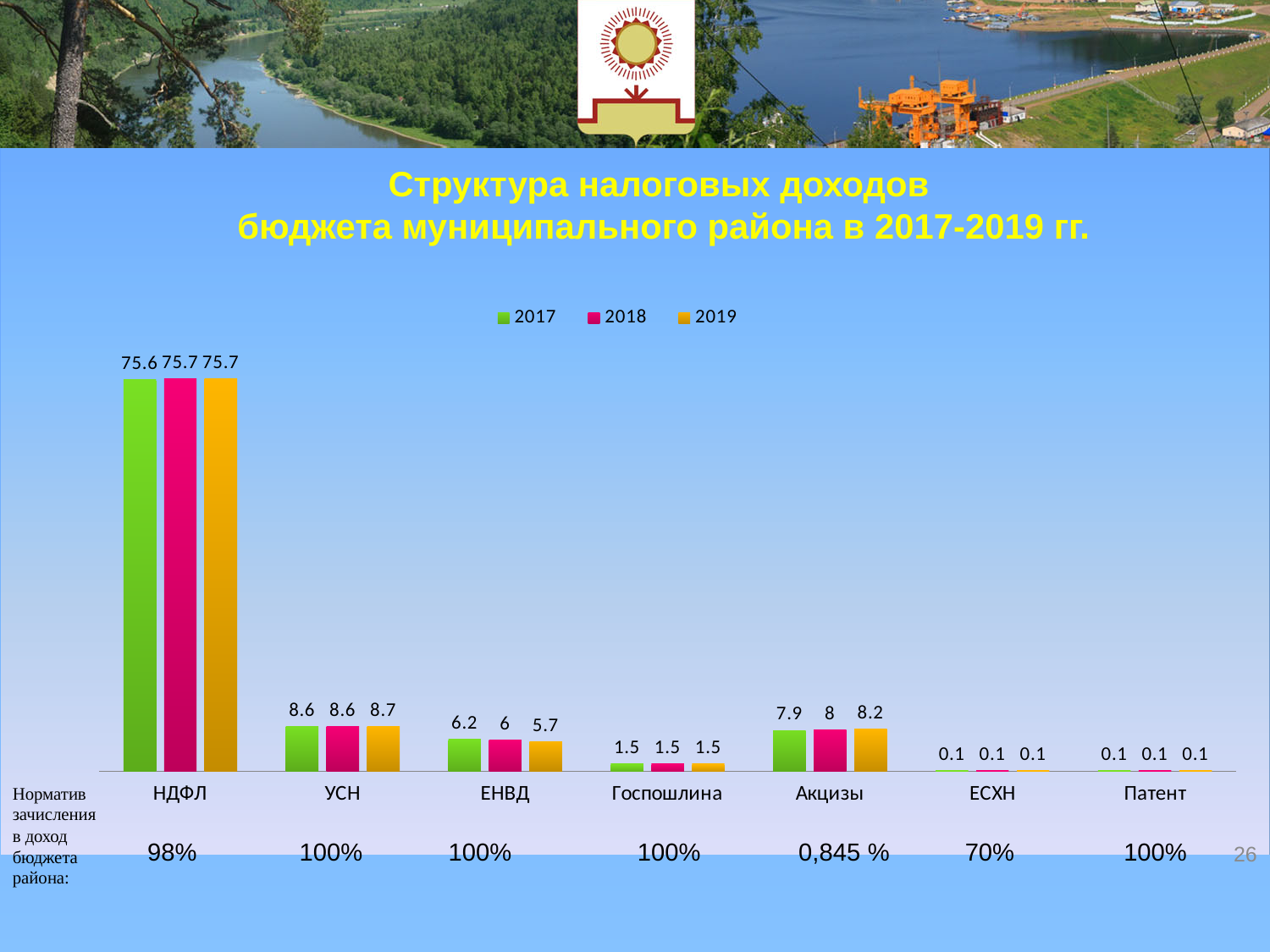
How many series does the legend list? 3 How many categories are shown on the x axis? 7 What is the value for ЕНВД in 2019? 5.7 What is the value for Акцизы in 2018? 8 What is the difference between the 2017 and 2019 values for ЕНВД? 0.5 What is the difference between the 2019 values for НДФЛ and УСН? 67 What is the value for НДФЛ in 2017? 75.6 Which category has the highest value in 2018? НДФЛ What kind of chart is shown on the slide? Bar chart Which is larger in 2019: УСН or Акцизы? УСН Do the values for ЕНВД rise or fall from 2017 to 2019? Fall What is the value for УСН in 2019? 8.7